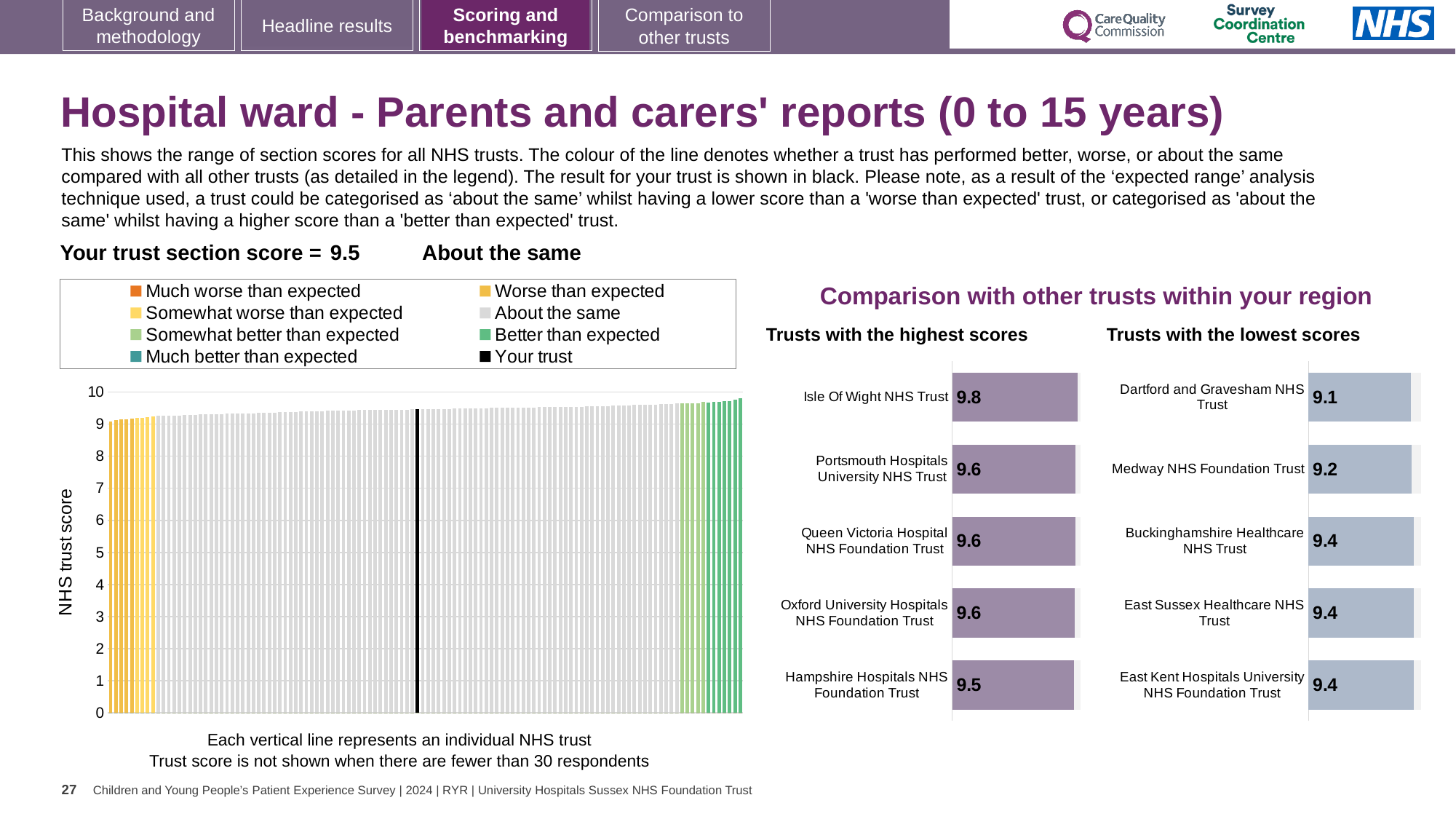
What is the label on the vertical axis of the chart on the left of the slide? NHS trust score In the 'Trusts with the lowest scores' chart, what is the score for East Kent Hospitals University NHS Foundation Trust? 9.4 In the 'Trusts with the lowest scores' chart, what is the score for Medway NHS Foundation Trust? 9.2 In the 'Trusts with the lowest scores' chart, which has the larger score: Dartford and Gravesham NHS Trust or Buckinghamshire Healthcare NHS Trust? Buckinghamshire Healthcare NHS Trust How many trusts are shown in the 'Trusts with the highest scores' chart? 5 How many entries does the legend above the 'NHS trust score' chart list? 8 In the 'NHS trust score' chart on the left, is the value for the black bar (Your trust) greater or less than 9? greater In the 'Trusts with the highest scores' chart, what is the score for Isle Of Wight NHS Trust? 9.8 In the 'Trusts with the highest scores' chart, which trust has the highest score? Isle Of Wight NHS Trust In the 'Trusts with the lowest scores' chart, which trust has the lowest score? Dartford and Gravesham NHS Trust What kind of chart is the 'NHS trust score' chart on the left of the slide? Bar chart In the 'Trusts with the highest scores' chart, what is the difference between the scores of Isle Of Wight NHS Trust and Hampshire Hospitals NHS Foundation Trust? 0.3